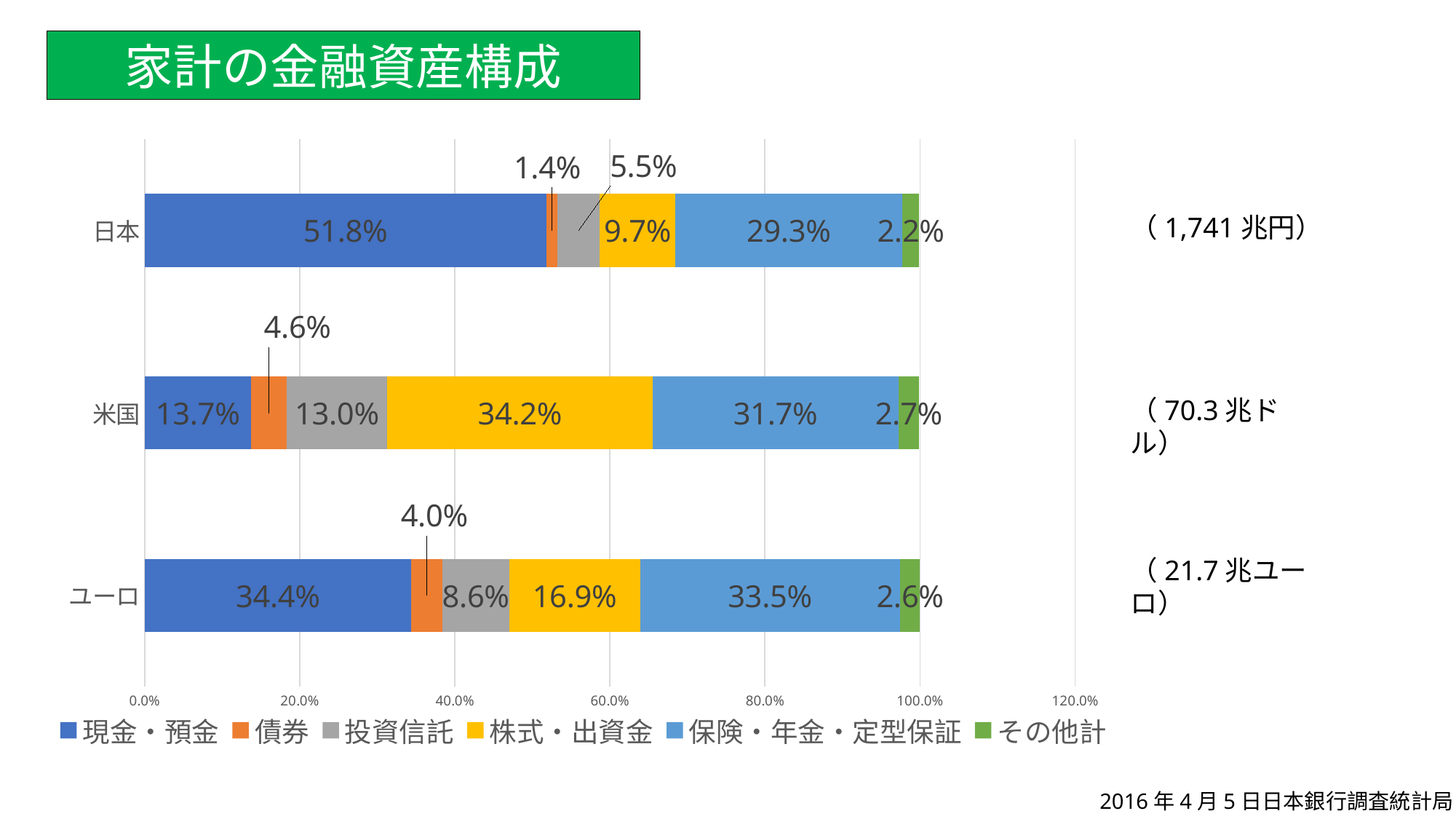
How many regions are shown in the chart? 3 What is the title of the slide? 家計の金融資産構成 What is the value of 保険・年金・定型保証 for ユーロ? 33.5% What is the value of 現金・預金 for 日本? 51.8% Which is larger: the 株式・出資金 share of 米国 or of ユーロ? 米国 What is the value of 投資信託 for 米国? 13.0% Which region has the highest share of 現金・預金? 日本 What is the difference between the 現金・預金 share of 日本 and that of 米国? 38.1 percentage points Which region has the lowest share of 債券? 日本 What is the value of 株式・出資金 for 米国? 34.2% What kind of chart is shown on the slide? Stacked bar chart How many series does the legend list? 6